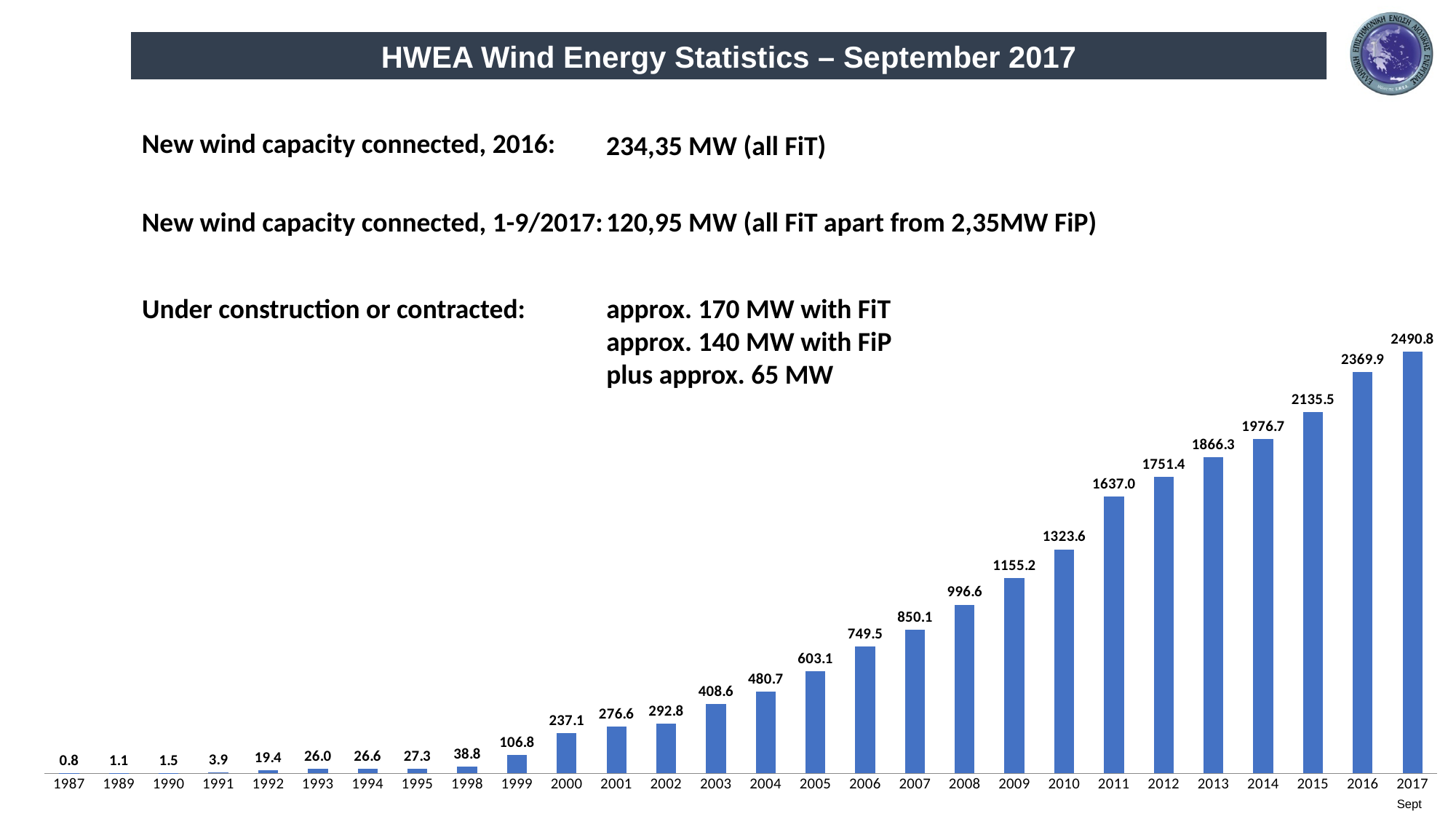
What kind of chart is shown on the slide? Bar chart Which is larger, the value for 2008 or the value for 2007? 2008 What is the value shown for 1999? 106.8 How many years (bars) are shown in the chart? 28 What is the difference between the values for 2017 and 2016? 120.9 What is the value shown for 2005? 603.1 Which year has the highest value in the chart? 2017 What colour are the bars in the chart? Blue What is the value shown for 2017? 2490.8 Which year has the lowest value in the chart? 1987 Do the values rise or fall from 1987 to 2017? Rise What is the difference between the values for 2016 and 2015? 234.4